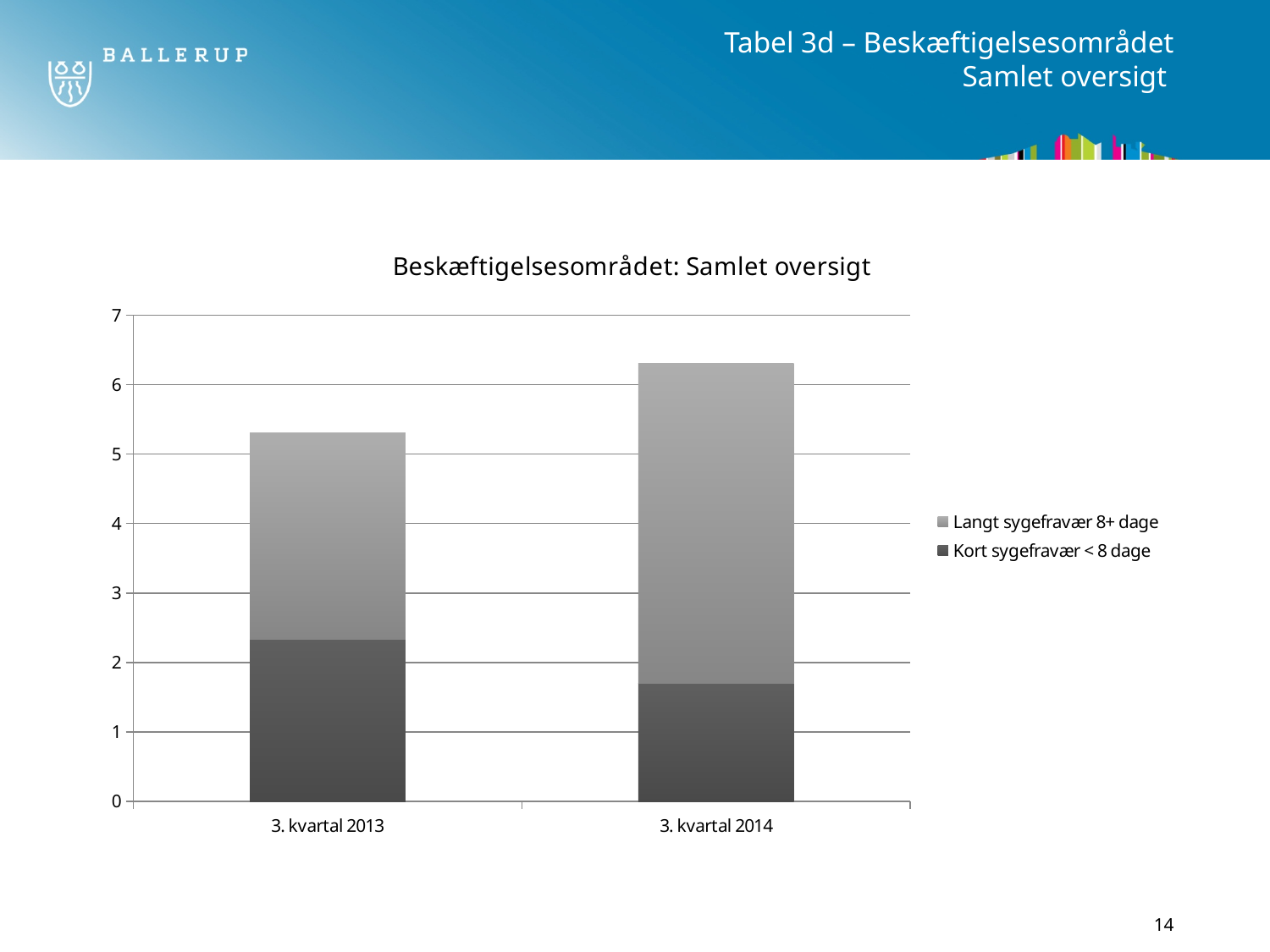
Which quarter has the larger Langt sygefravær 8+ dage segment? 3. kvartal 2014 How many series does the legend list? 2 Is the total bar for 3. kvartal 2013 greater or less than 5? greater Is the total bar for 3. kvartal 2014 greater or less than 6? greater What kind of chart is shown on the slide? Stacked bar chart What is the title of the chart? Beskæftigelsesområdet: Samlet oversigt Which quarter has the larger Kort sygefravær < 8 dage segment? 3. kvartal 2013 How many categories are shown on the x axis? 2 Does the total bar rise or fall from 3. kvartal 2013 to 3. kvartal 2014? rise Is the Kort sygefravær < 8 dage value for 3. kvartal 2014 greater or less than 2? less Which quarter has the higher total bar? 3. kvartal 2014 Which series is shown in the darker colour at the bottom of each bar? Kort sygefravær < 8 dage